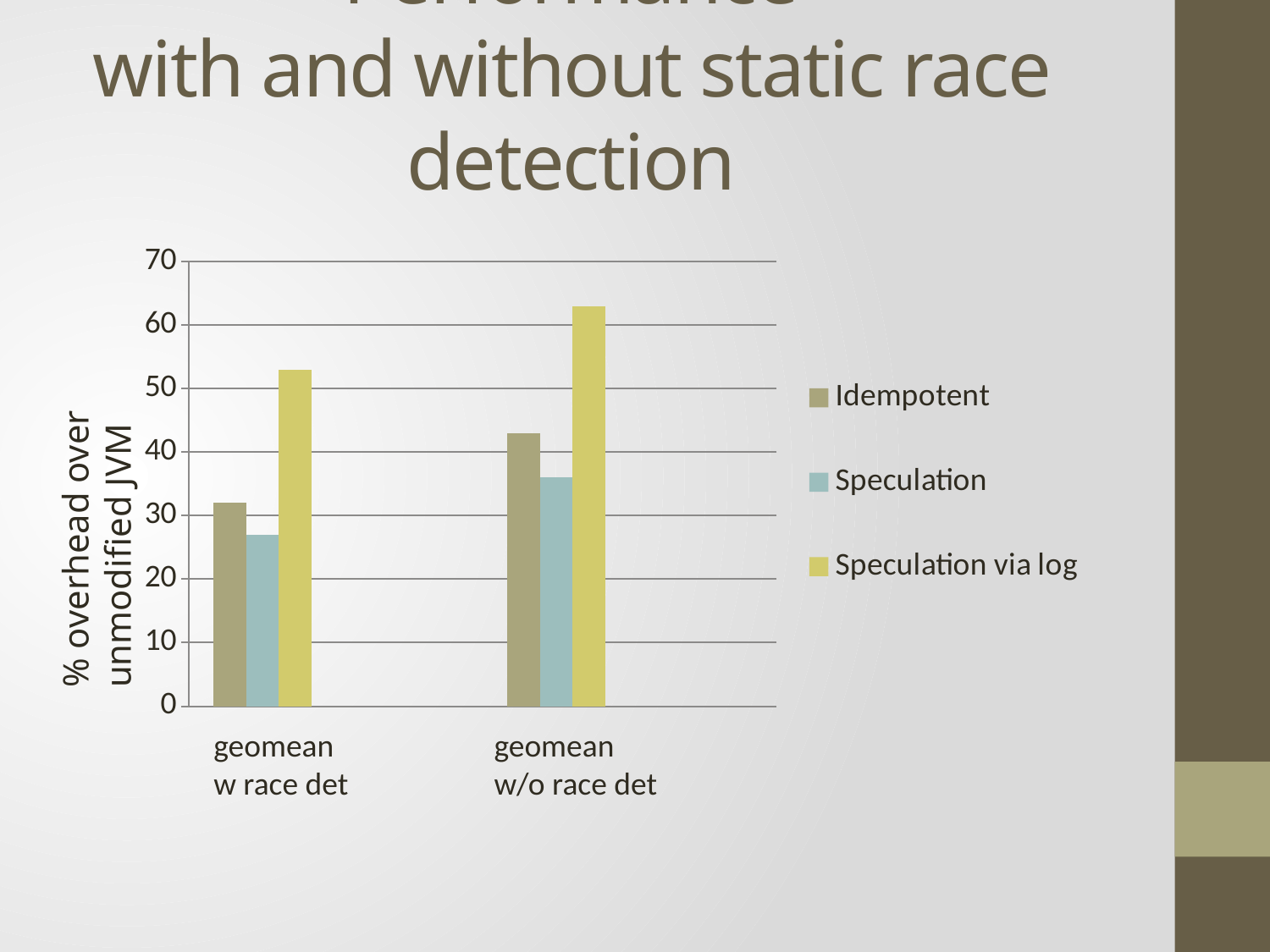
Is the value for Speculation via log at geomean w race det greater or less than 50? greater Does the Speculation series rise or fall from geomean w race det to geomean w/o race det? rise What is the label on the vertical axis? % overhead over unmodified JVM Which is larger: Idempotent at geomean w race det or Idempotent at geomean w/o race det? Idempotent at geomean w/o race det Is the value for Speculation via log at geomean w/o race det greater or less than 60? greater How many categories are shown on the x axis? 2 Which series has the highest value for geomean w race det? Speculation via log Is the value for Speculation at geomean w race det greater or less than 30? less What kind of chart is shown on the slide? bar chart Which series has the lowest value for geomean w/o race det? Speculation How many series does the legend list? 3